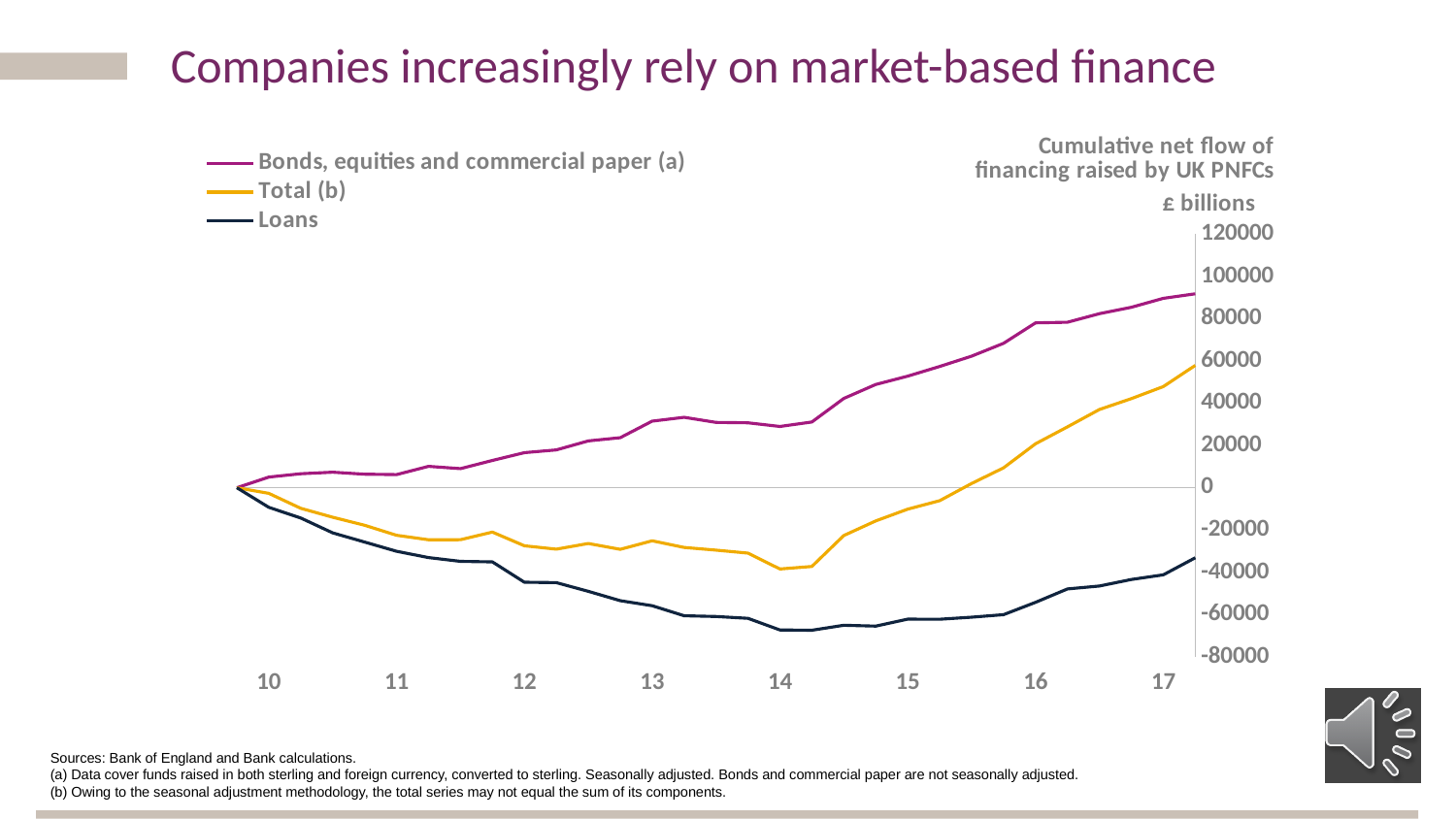
How many year labels are shown on the x axis? 8 What kind of chart is shown on the slide? line chart Is the value of 'Loans' at 14 greater or less than -60000? less Does the 'Bonds, equities and commercial paper (a)' series rise or fall from 10 to 17 along the x axis? rise How many series does the legend list? 3 Is the value of 'Total (b)' at 16 greater or less than 0? greater What is the title of the chart? Cumulative net flow of financing raised by UK PNFCs What unit is shown above the vertical axis? £ billions At 17 on the x axis, which is higher: 'Bonds, equities and commercial paper (a)' or 'Total (b)'? Bonds, equities and commercial paper (a) Which series reaches the lowest value on the chart? Loans Does the 'Loans' series rise or fall between 10 and 14 on the x axis? fall Is the value of 'Bonds, equities and commercial paper (a)' at 17 greater or less than 80000? greater